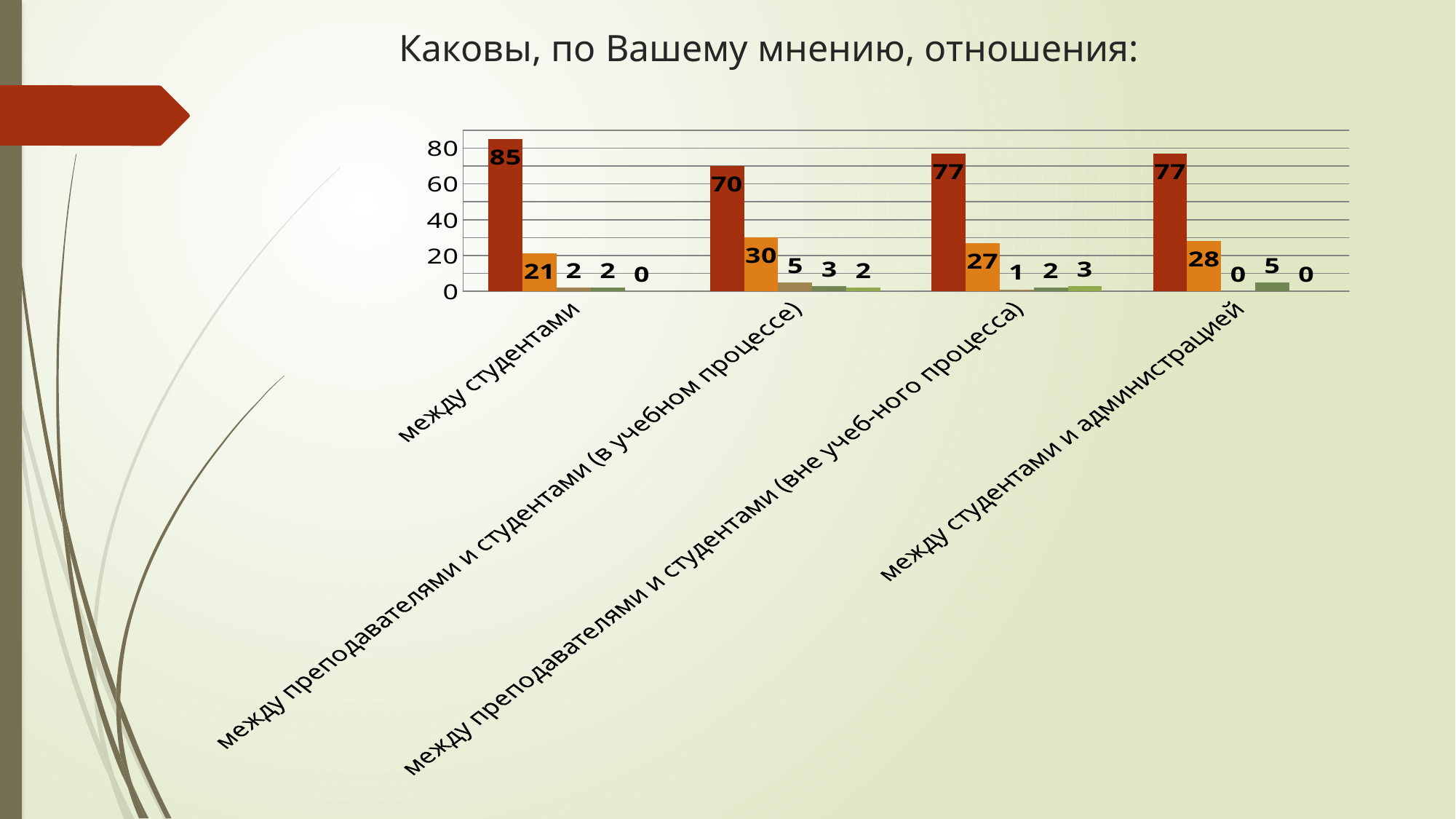
What is the value of the orange bar for "между преподавателями и студентами (в учебном процессе)"? 30 What type of chart is shown on the slide? bar chart Which category has the lowest dark red bar? между преподавателями и студентами (в учебном процессе) What is the title of the slide containing the chart? Каковы, по Вашему мнению, отношения: Which is larger: the orange bar for "между студентами" or the orange bar for "между студентами и администрацией"? между студентами и администрацией What is the value of the dark red bar for "между студентами"? 85 Is the dark red bar for "между преподавателями и студентами (в учебном процессе)" greater or less than 80? less What is the value of the dark red bar for "между студентами и администрацией"? 77 What is the value of the orange bar for "между преподавателями и студентами (вне учеб-ного процесса)"? 27 How many categories are shown on the x axis of the chart? 4 Which category has the highest dark red bar? между студентами What is the difference between the dark red bar values for "между студентами" and "между преподавателями и студентами (в учебном процессе)"? 15